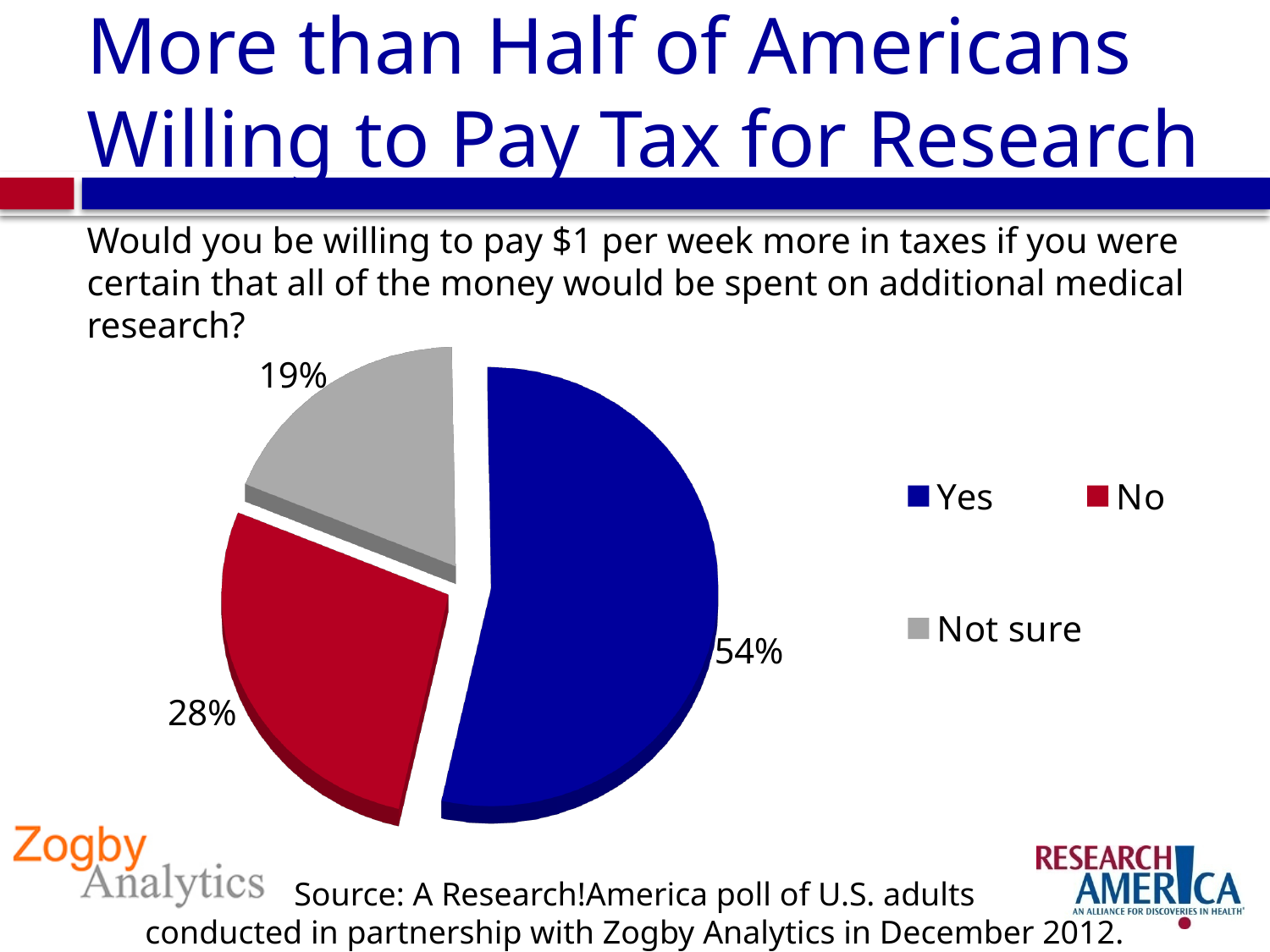
Which response is shown in grey in the legend? Not sure What is the difference in percentage points between the No and Not sure responses? 9 Which response has the smallest share of the pie? Not sure What kind of chart is shown on the slide? Pie chart What percentage of respondents answered Yes? 54% Which is larger, the share for No or the share for Not sure? No How many slices does the pie chart have? 3 What percentage of respondents answered No? 28% Which response has the largest share of the pie? Yes What colour is the slice representing Yes? Blue What percentage of respondents answered Not sure? 19% What is the difference in percentage points between the Yes and No responses? 26